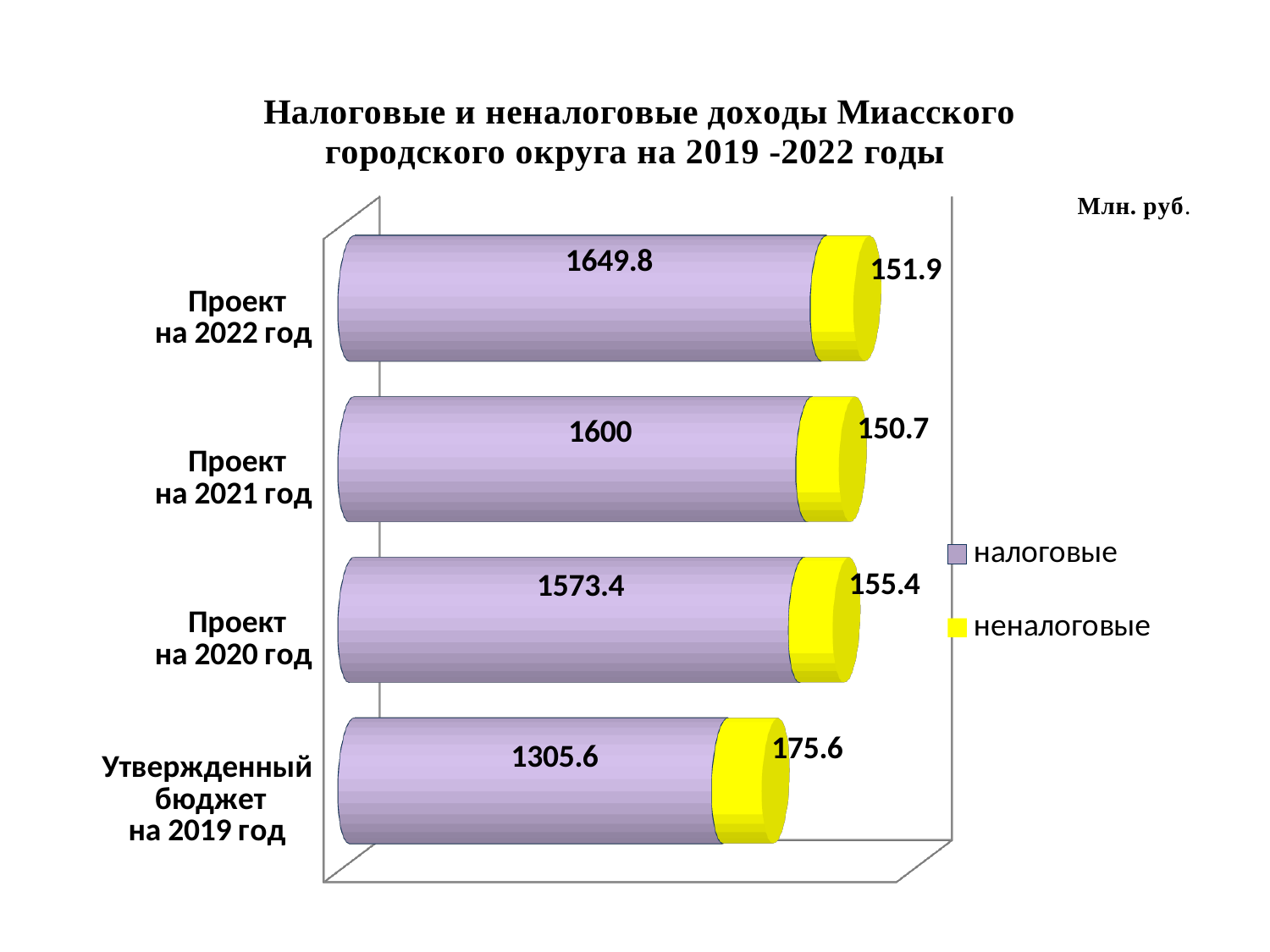
What is the value of налоговые for Проект на 2021 год? 1600 Which category has the lowest неналоговые value? Проект на 2021 год Which category has the highest налоговые value? Проект на 2022 год What unit is indicated on the chart? Млн. руб. What is the difference between the налоговые values for Проект на 2022 год and Утвержденный бюджет на 2019 год? 344.2 Which is larger: the неналоговые value for Проект на 2020 год or for Проект на 2022 год? Проект на 2020 год How many series does the legend list? 2 What is the value of налоговые for Проект на 2022 год? 1649.8 What is the total of the stacked bar for Проект на 2020 год? 1728.8 How many categories are shown on the chart? 4 What kind of chart is shown on the slide? Stacked bar chart What is the value of неналоговые for Утвержденный бюджет на 2019 год? 175.6